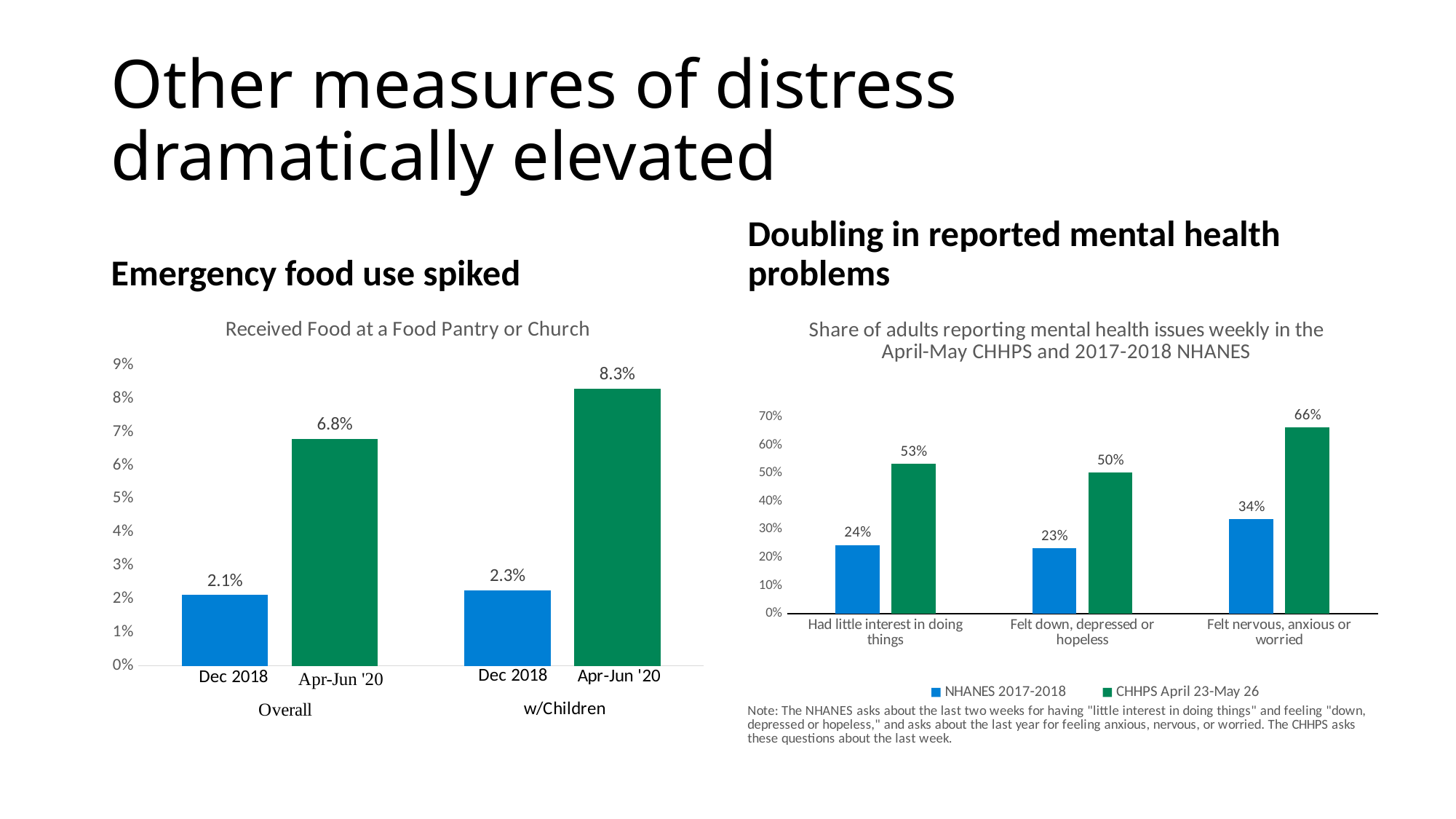
In the 'Received Food at a Food Pantry or Church' chart, how many bars are plotted? 4 In the 'Received Food at a Food Pantry or Church' chart, what is the value for Dec 2018 in the w/Children group? 2.3% In the 'Share of adults reporting mental health issues weekly' chart, what is the difference between the CHHPS and NHANES values for 'Had little interest in doing things'? 29% In the 'Share of adults reporting mental health issues weekly' chart, what is the NHANES 2017-2018 value for 'Felt down, depressed or hopeless'? 23% In the 'Received Food at a Food Pantry or Church' chart, what is the value for Apr-Jun '20 in the Overall group? 6.8% In the 'Share of adults reporting mental health issues weekly' chart, which series is shown in green? CHHPS April 23-May 26 In the 'Received Food at a Food Pantry or Church' chart, what is the difference between the Apr-Jun '20 and Dec 2018 values for the Overall group? 4.7% How many series does the legend of the 'Share of adults reporting mental health issues weekly' chart list? 2 In the 'Share of adults reporting mental health issues weekly' chart, which category has the lowest NHANES 2017-2018 value? Felt down, depressed or hopeless What kind of chart is the 'Received Food at a Food Pantry or Church' chart? Bar chart In the 'Share of adults reporting mental health issues weekly' chart, what is the CHHPS April 23-May 26 value for 'Felt nervous, anxious or worried'? 66% In the 'Received Food at a Food Pantry or Church' chart, which bar has the highest value? Apr-Jun '20, w/Children